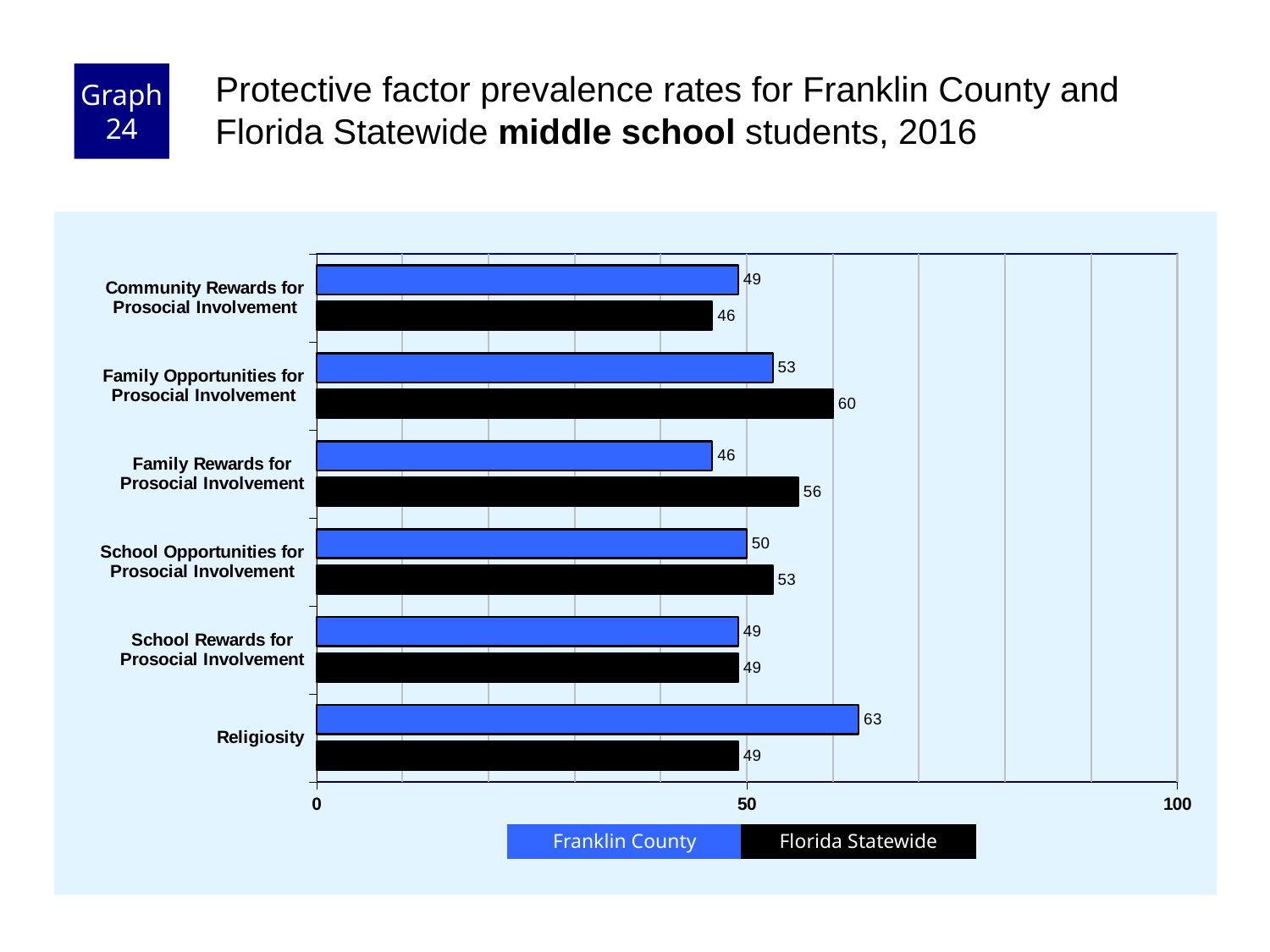
Which category has the lowest Florida Statewide value? Community Rewards for Prosocial Involvement What is the difference between the Florida Statewide and Franklin County values for Family Rewards for Prosocial Involvement? 10 Which is larger for Family Opportunities for Prosocial Involvement, the Franklin County value or the Florida Statewide value? Florida Statewide How many protective factor categories are shown on the chart? 6 What is the Florida Statewide value for Family Opportunities for Prosocial Involvement? 60 How many series does the legend list? 2 What is the Franklin County value for Religiosity? 63 What is the Franklin County value for Family Rewards for Prosocial Involvement? 46 Which category has the highest Franklin County value? Religiosity What kind of chart is shown on the slide? Bar chart Is the Franklin County value for Religiosity greater or less than 50? greater What colour are the Florida Statewide bars? Black